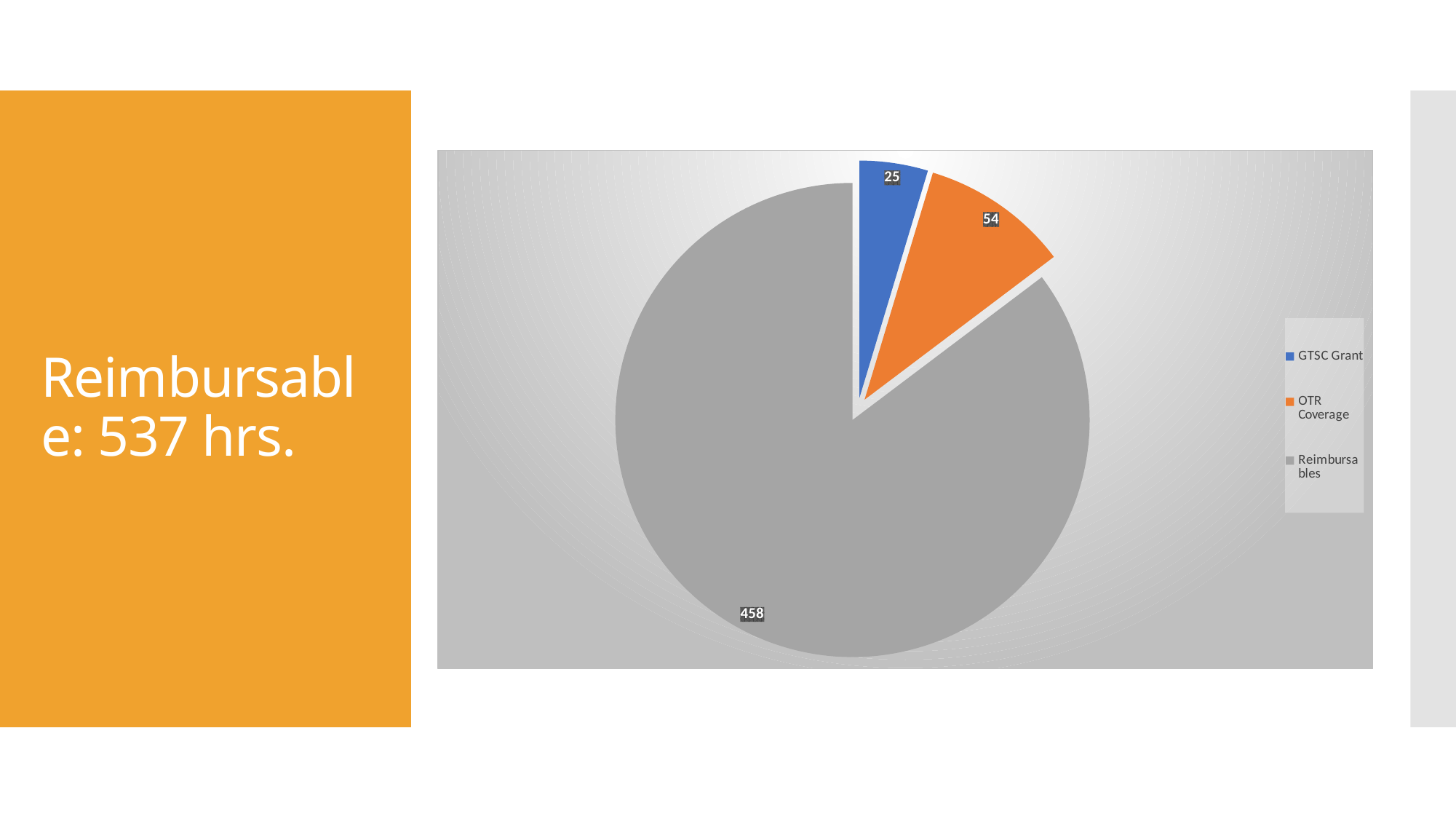
What kind of chart is shown on the slide? pie chart Which category has the smallest slice? GTSC Grant What is the value for OTR Coverage? 54 Which is larger, OTR Coverage or GTSC Grant? OTR Coverage How many slices does the pie chart have? 3 What is the difference between the values for Reimbursables and OTR Coverage? 404 What is the value for GTSC Grant? 25 What is the value for Reimbursables? 458 Which category has the largest slice? Reimbursables What colour is the Reimbursables slice? grey What is the total of all slices in the pie chart? 537 What is the difference between the values for OTR Coverage and GTSC Grant? 29